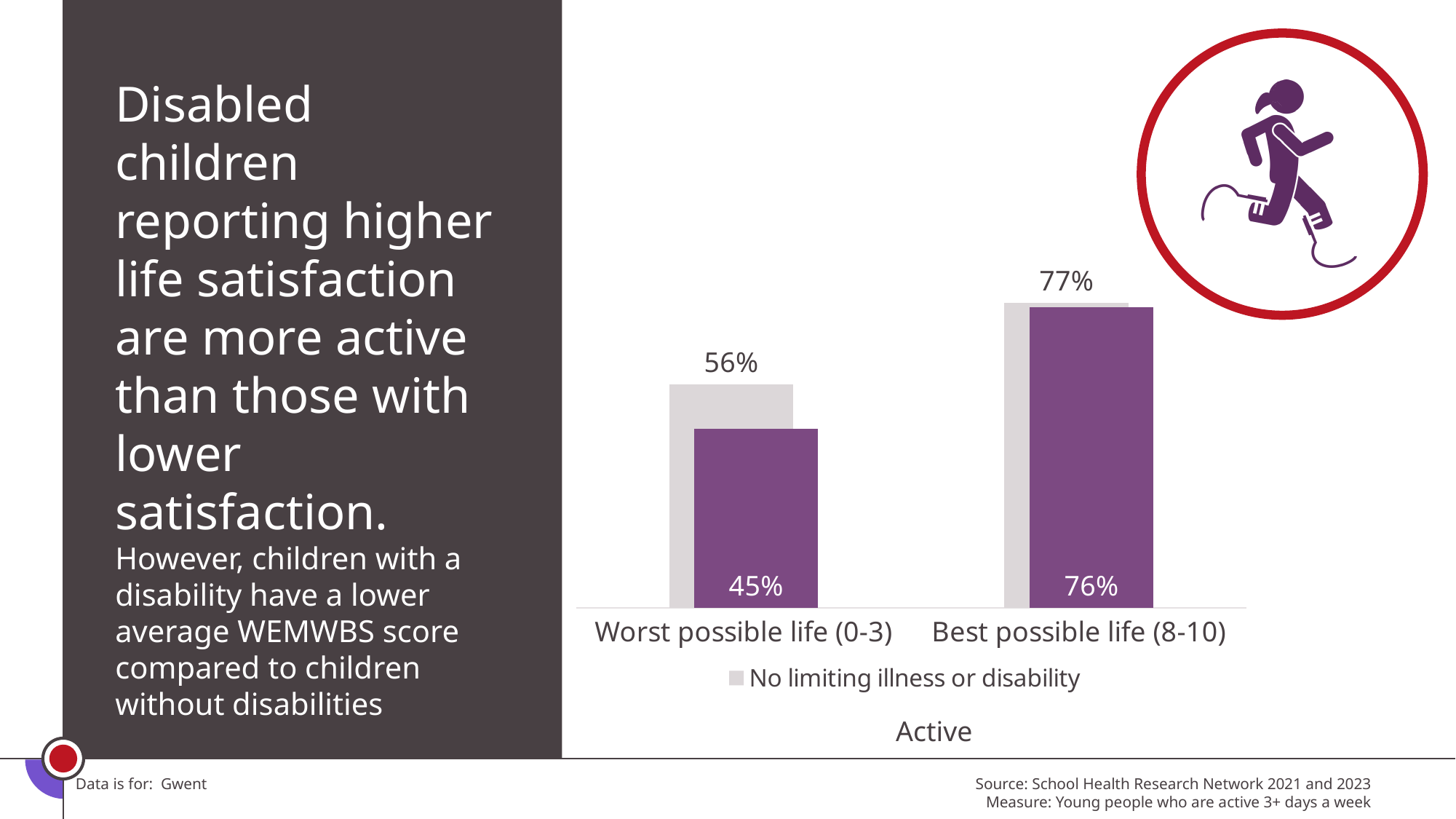
What is the value of the purple bar for 'Best possible life (8-10)'? 76% What is the difference between the 'No limiting illness or disability' values for 'Best possible life (8-10)' and 'Worst possible life (0-3)'? 21 percentage points For 'Worst possible life (0-3)', which bar is larger: the grey 'No limiting illness or disability' bar or the purple bar? The grey 'No limiting illness or disability' bar What is the value of the 'No limiting illness or disability' bar for 'Worst possible life (0-3)'? 56% What is the value of the 'No limiting illness or disability' bar for 'Best possible life (8-10)'? 77% What is the difference between the grey and purple bars for 'Worst possible life (0-3)'? 11 percentage points What type of chart is shown on the slide? Bar chart What is the value of the purple bar for 'Worst possible life (0-3)'? 45% What is the lowest value shown in the chart? 45% What is the difference between the grey and purple bars for 'Best possible life (8-10)'? 1 percentage point What is the highest value shown in the chart? 77% How many categories are shown on the x axis of the chart? 2